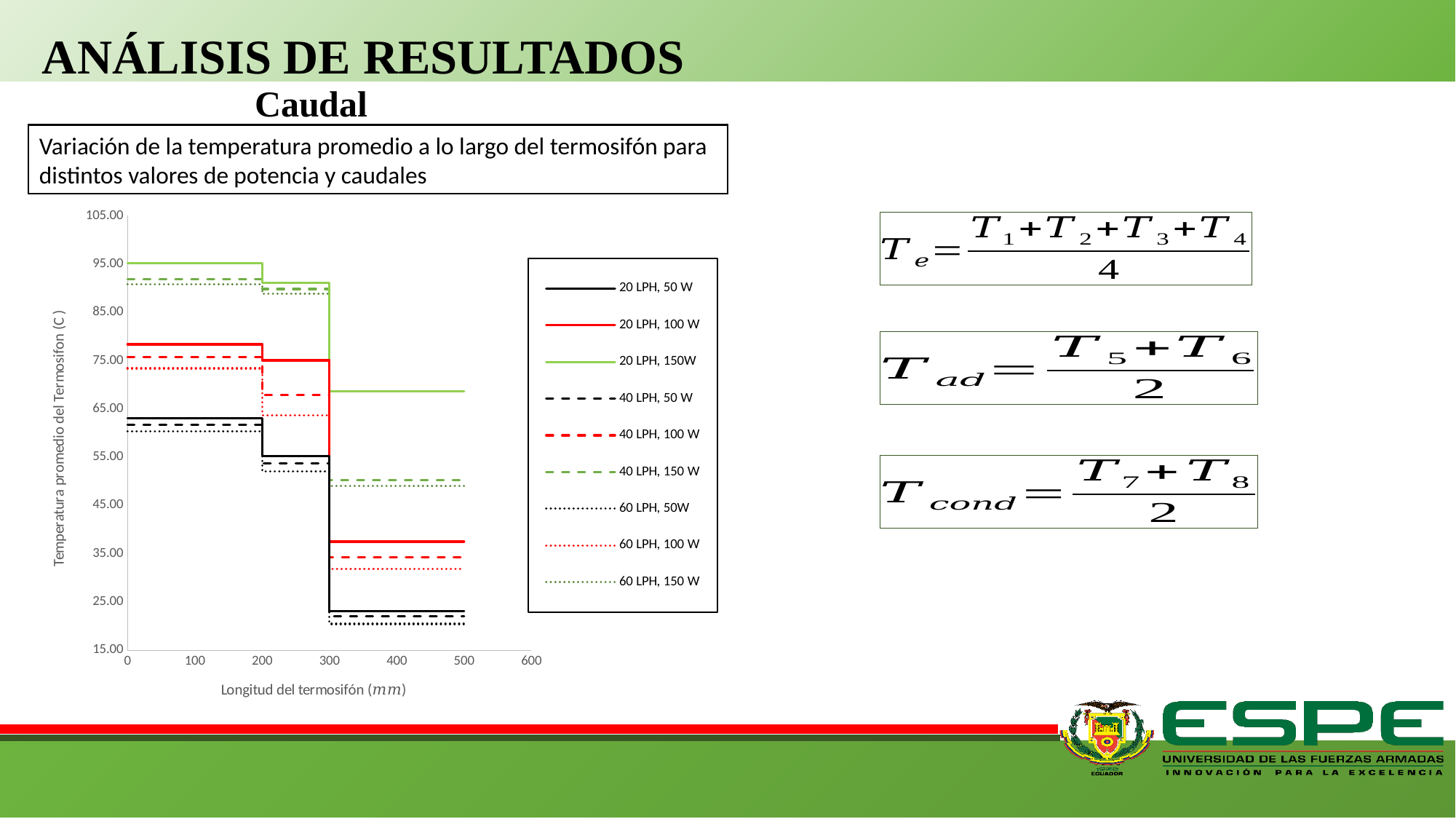
What kind of chart is shown on the slide? line chart What colour are the 150 W series lines in the chart? green Over the 300 to 500 mm section, which is higher: the temperature for 20 LPH, 150W or for 20 LPH, 50 W? 20 LPH, 150W How many series does the chart legend list? 9 Which series has the lowest temperature over the 300 to 500 mm section? 60 LPH, 50W Over the 300 to 500 mm section, is the temperature for 20 LPH, 100 W greater or less than 35.00? greater Over the 0 to 200 mm section, is the temperature for 20 LPH, 50 W greater or less than 65.00? less Do the temperature values rise or fall as the length of the thermosiphon increases along the x axis? fall Which series has the highest temperature over the 0 to 200 mm section? 20 LPH, 150W Over the 300 to 500 mm section, is the temperature for 20 LPH, 150W greater or less than 65.00? greater What is the title of the y axis of the chart? Temperatura promedio del Termosifón (C )